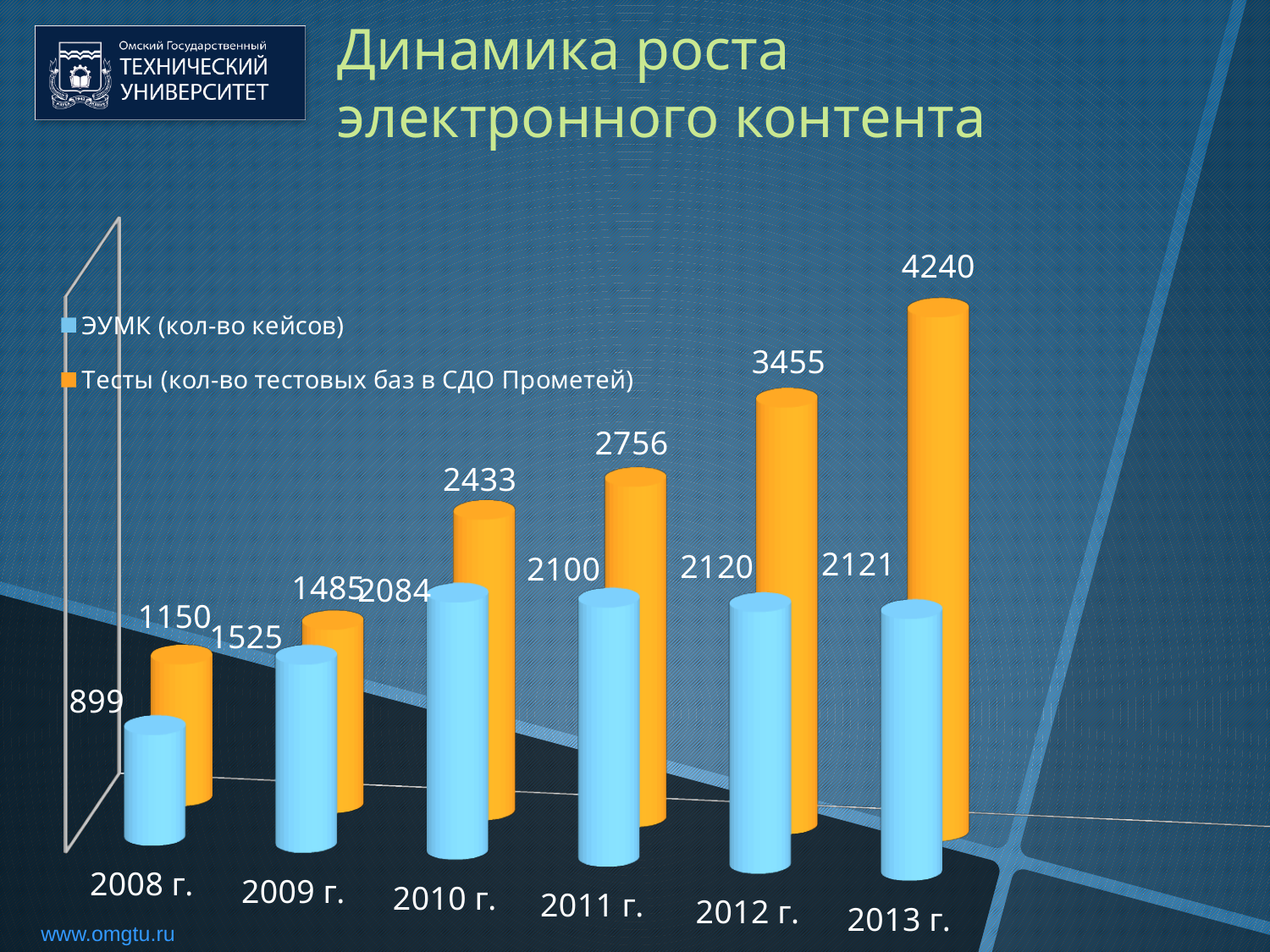
In 2013 г., which series has the larger value, ЭУМК (кол-во кейсов) or Тесты (кол-во тестовых баз в СДО Прометей)? Тесты (кол-во тестовых баз в СДО Прометей) How many series does the legend list? 2 In which year is the value for ЭУМК (кол-во кейсов) lowest? 2008 г. What is the difference between the Тесты values for 2013 г. and 2012 г.? 785 In which year is the value for Тесты (кол-во тестовых баз в СДО Прометей) highest? 2013 г. What is the value for Тесты (кол-во тестовых баз в СДО Прометей) in 2013 г.? 4240 Do the values for Тесты (кол-во тестовых баз в СДО Прометей) rise or fall from 2008 г. to 2013 г.? rise What kind of chart is shown on the slide? bar chart What is the value for Тесты (кол-во тестовых баз в СДО Прометей) in 2012 г.? 3455 What is the value for ЭУМК (кол-во кейсов) in 2011 г.? 2100 How many years are shown on the x axis? 6 What is the value for ЭУМК (кол-во кейсов) in 2008 г.? 899